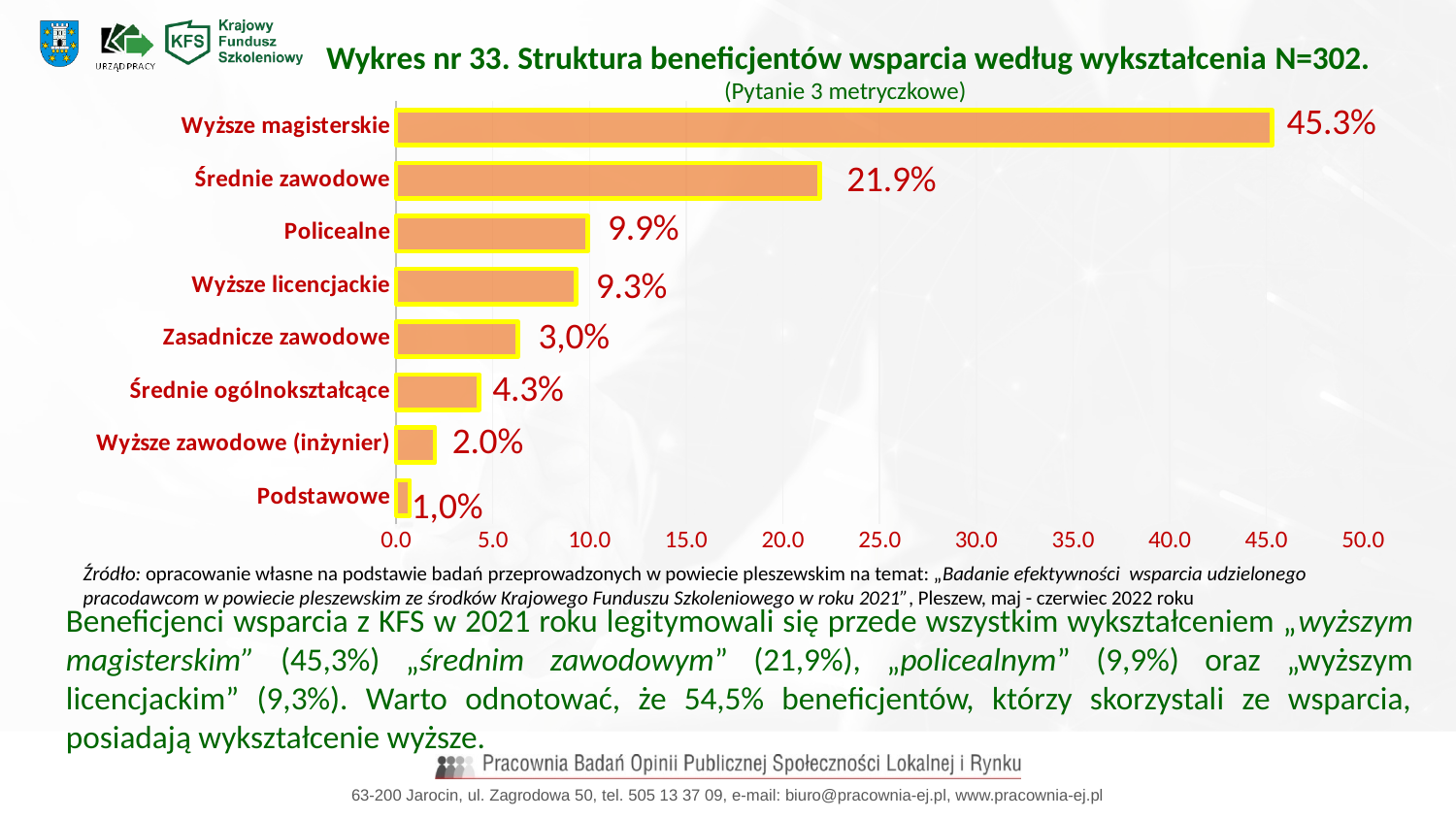
What is the value for Wyższe magisterskie? 45.3% What is the difference between the values for Wyższe magisterskie and Średnie zawodowe? 23.4 percentage points Which category has the lowest value? Podstawowe How many categories are shown in the chart? 8 What is the value for Wyższe zawodowe (inżynier)? 2.0% What kind of chart is shown on the slide? Bar chart Is the value for Średnie zawodowe greater or less than 20.0? greater What is the value for Średnie zawodowe? 21.9% Which category has the highest value? Wyższe magisterskie What is the value for Policealne? 9.9%